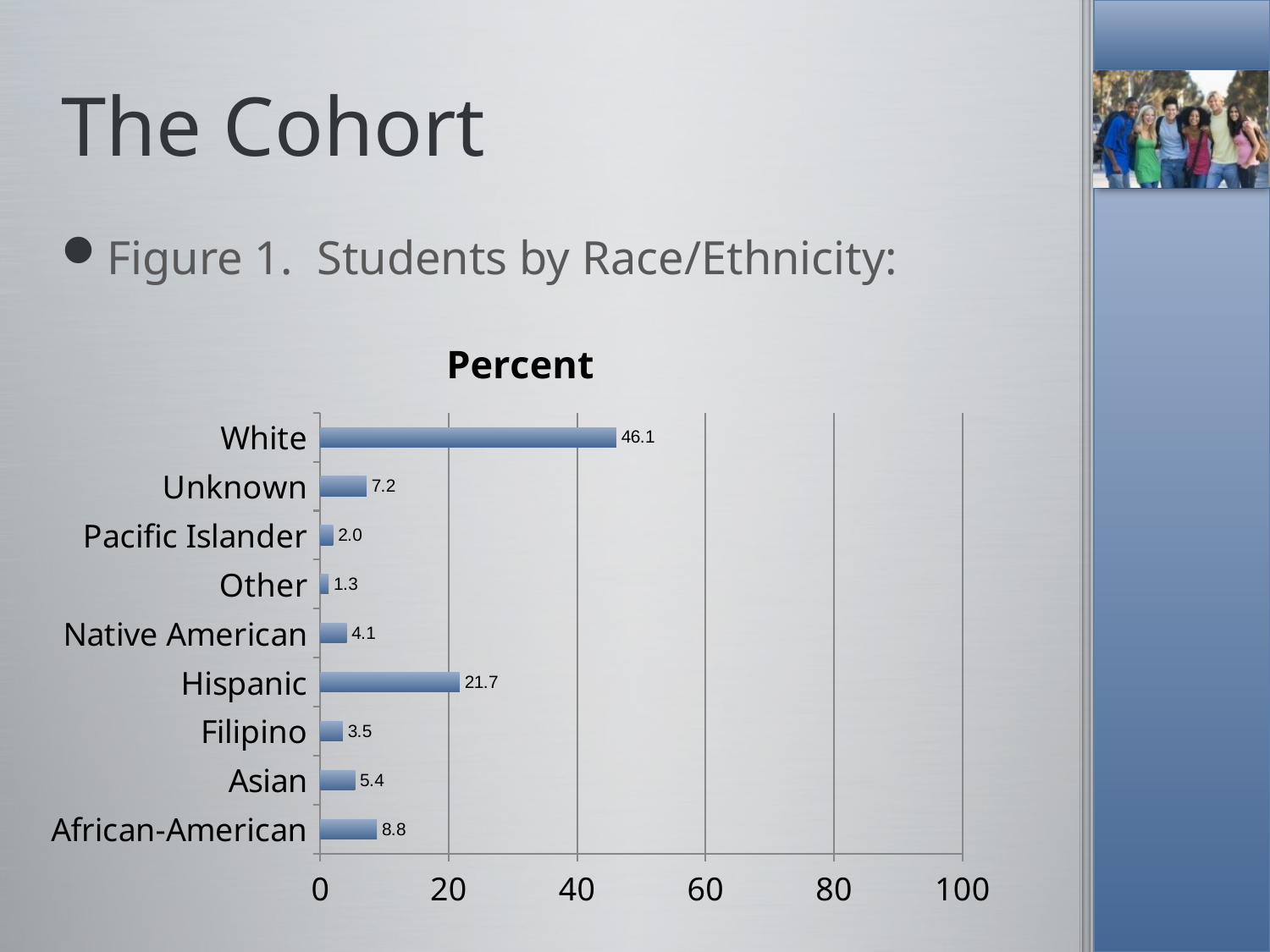
What is the value for Pacific Islander? 2.0 What is the value for White? 46.1 What is the value for Hispanic? 21.7 What is the value for African-American? 8.8 What kind of chart is shown on the slide? bar chart What is the difference between the values for White and Hispanic? 24.4 Which category has the lowest value? Other Which is larger, the value for Asian or the value for Filipino? Asian What is the title of the chart? Percent How many categories are shown in the chart? 9 Which category has the highest value? White Is the value for White greater or less than 40? greater